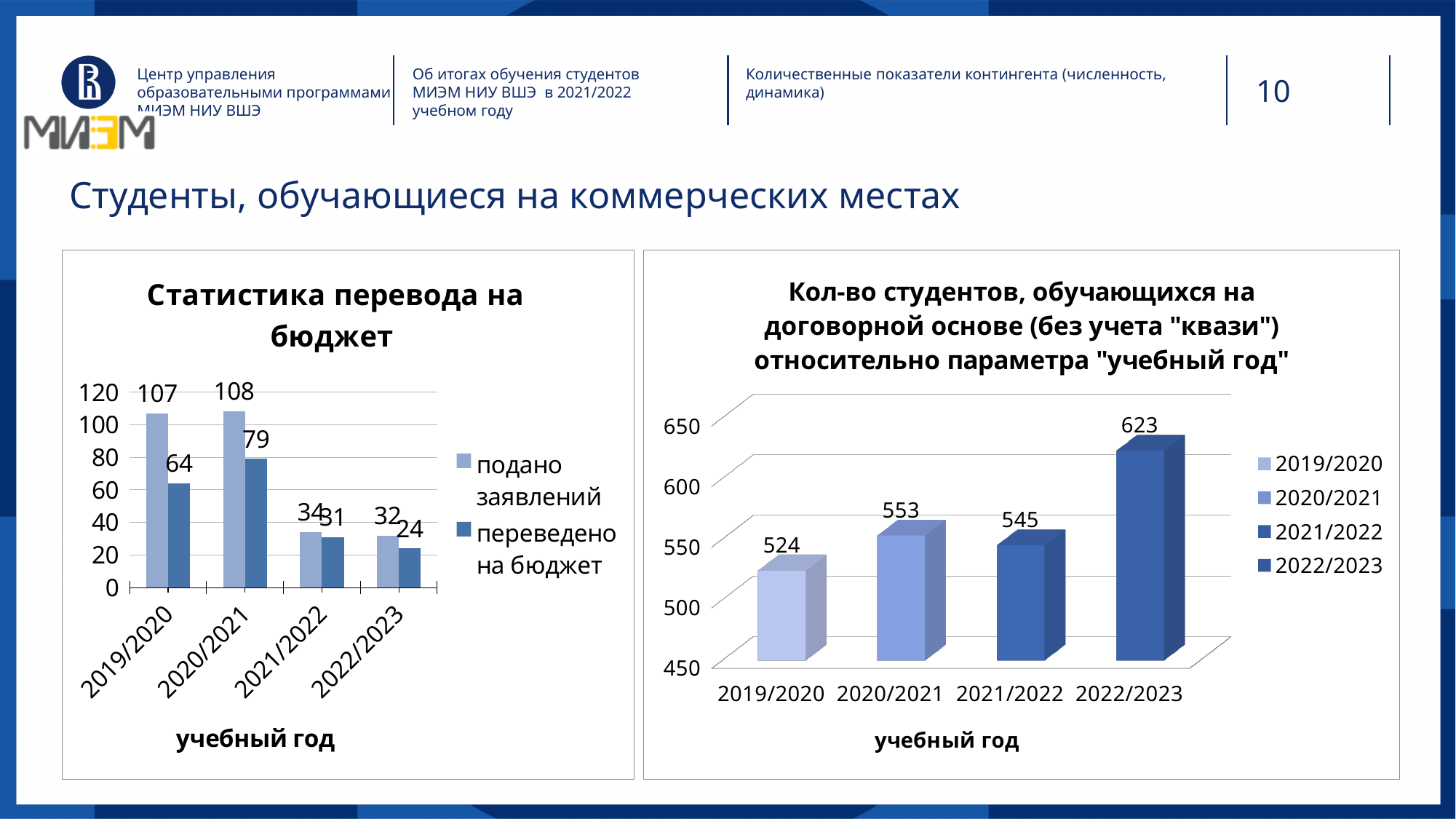
In the right chart, which academic year has the highest number of students on a contractual basis? 2022/2023 In the left chart "Статистика перевода на бюджет", which academic year has the lowest value for переведено на бюджет? 2022/2023 In the right chart, what is the difference between the values for 2022/2023 and 2019/2020? 99 In the left chart "Статистика перевода на бюджет", how many series does the legend list? 2 What type of chart is the right chart on the slide? bar chart In the left chart "Статистика перевода на бюджет", how many students were transferred to budget places (переведено на бюджет) in 2019/2020? 64 In the left chart "Статистика перевода на бюджет", how many applications (подано заявлений) were submitted in 2020/2021? 108 In the right chart, which academic year has the lowest number of students on a contractual basis? 2019/2020 In the right chart, which is larger: the value for 2020/2021 or the value for 2021/2022? 2020/2021 In the right chart, how many students studied on a contractual basis in 2021/2022? 545 In the left chart "Статистика перевода на бюджет", what is the difference between подано заявлений and переведено на бюджет in 2020/2021? 29 In the left chart "Статистика перевода на бюджет", does the value for подано заявлений fall or rise from 2020/2021 to 2021/2022? fall